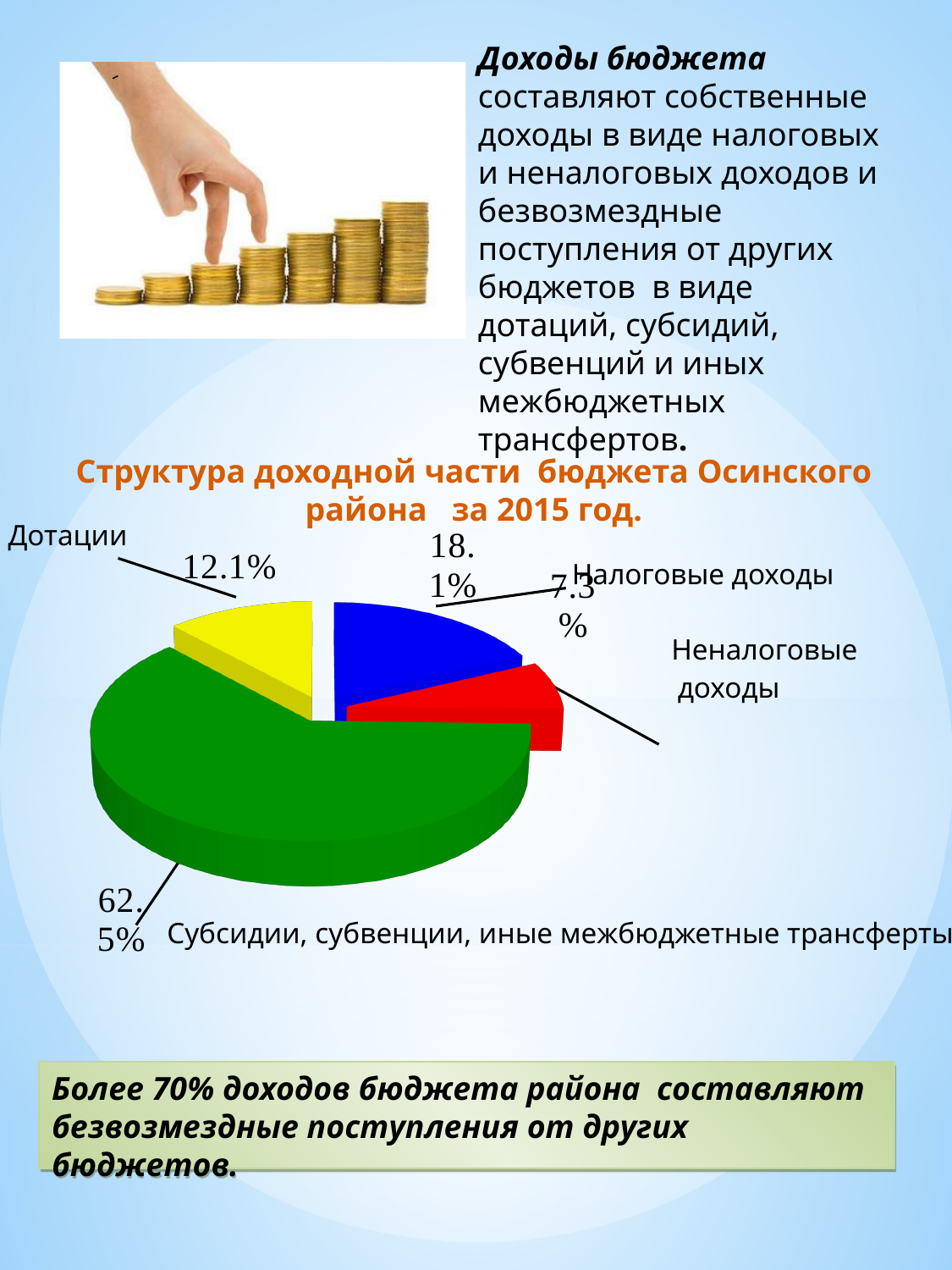
What share of the pie is Дотации? 12.1% What colour is the slice for Субсидии, субвенции, иные межбюджетные трансферты? green What share of the pie is Субсидии, субвенции, иные межбюджетные трансферты? 62.5% Which category has the largest share of the pie? Субсидии, субвенции, иные межбюджетные трансферты What share of the pie is Налоговые доходы? 18.1% What is the difference in percentage points between Налоговые доходы and Неналоговые доходы? 10.8 What share of the pie is Неналоговые доходы? 7.3% What is the title of the pie chart? Структура доходной части бюджета Осинского района за 2015 год. Which is larger, the share for Налоговые доходы or the share for Дотации? Налоговые доходы What kind of chart is shown on the slide? pie chart Which category has the smallest share of the pie? Неналоговые доходы How many slices does the pie chart have? 4